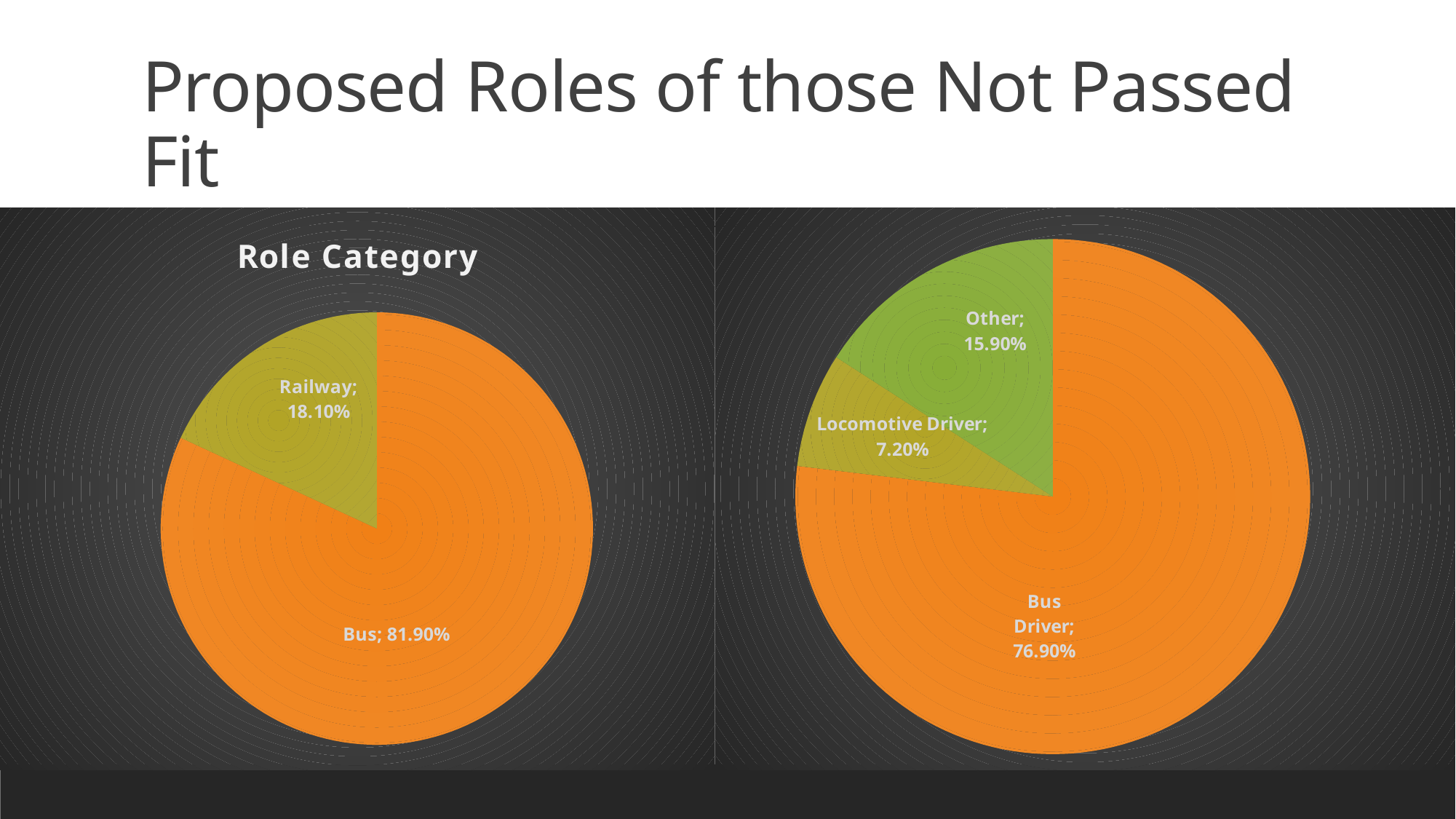
In the 'Role Category' chart on the left, which category has the largest share? Bus In the pie chart on the right, which is larger, Other or Locomotive Driver? Other In the pie chart on the right, what is the value for Bus Driver? 76.90% In the 'Role Category' chart on the left, what is the value for Railway? 18.10% In the 'Role Category' chart on the left, what is the value for Bus? 81.90% In the pie chart on the right, how many slices does the pie have? 3 In the pie chart on the right, what is the difference between the Other and Locomotive Driver shares? 8.70% In the pie chart on the right, what is the value for Locomotive Driver? 7.20% What kind of chart is the 'Role Category' chart on the left? Pie chart In the pie chart on the right, what is the value for Other? 15.90% In the pie chart on the right, which category has the smallest share? Locomotive Driver In the 'Role Category' chart on the left, how many slices does the pie have? 2